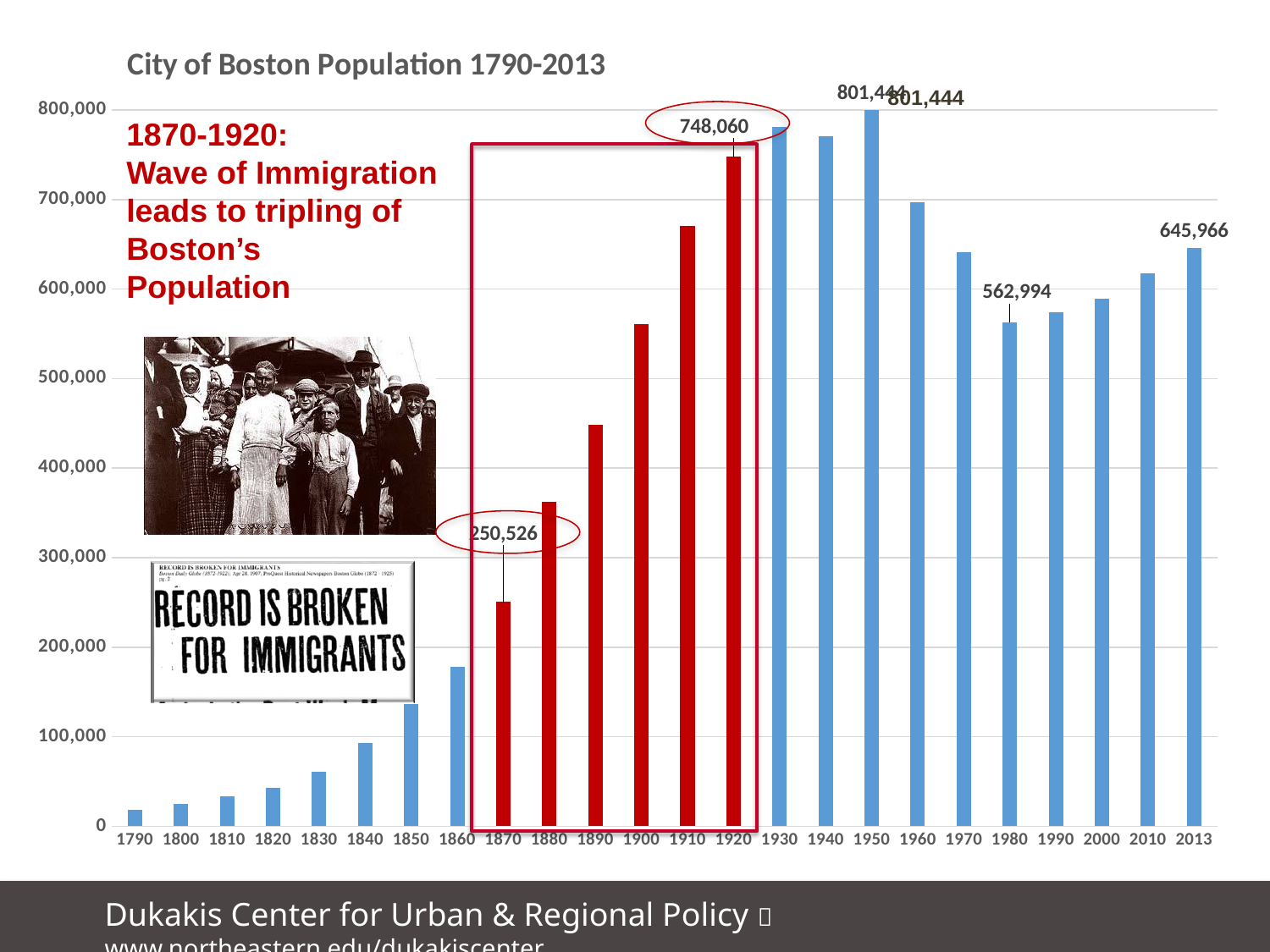
What was the population of Boston in 1920 according to the chart? 748,060 What value is labelled for 1980 on the chart? 562,994 Which year has the lowest population on the chart? 1790 Which year has the highest population on the chart? 1950 Is the value for 1900 greater or less than 500,000? greater How many years are shown along the x axis of the chart? 24 What kind of chart is shown on the slide? bar chart Which years are shown with red bars on the chart? 1870 to 1920 By how much did Boston's population grow between 1870 and 1920? 497,534 What was the population of Boston in 1870 according to the chart? 250,526 What is the title of the chart? City of Boston Population 1790-2013 What value is labelled for 2013 on the chart? 645,966